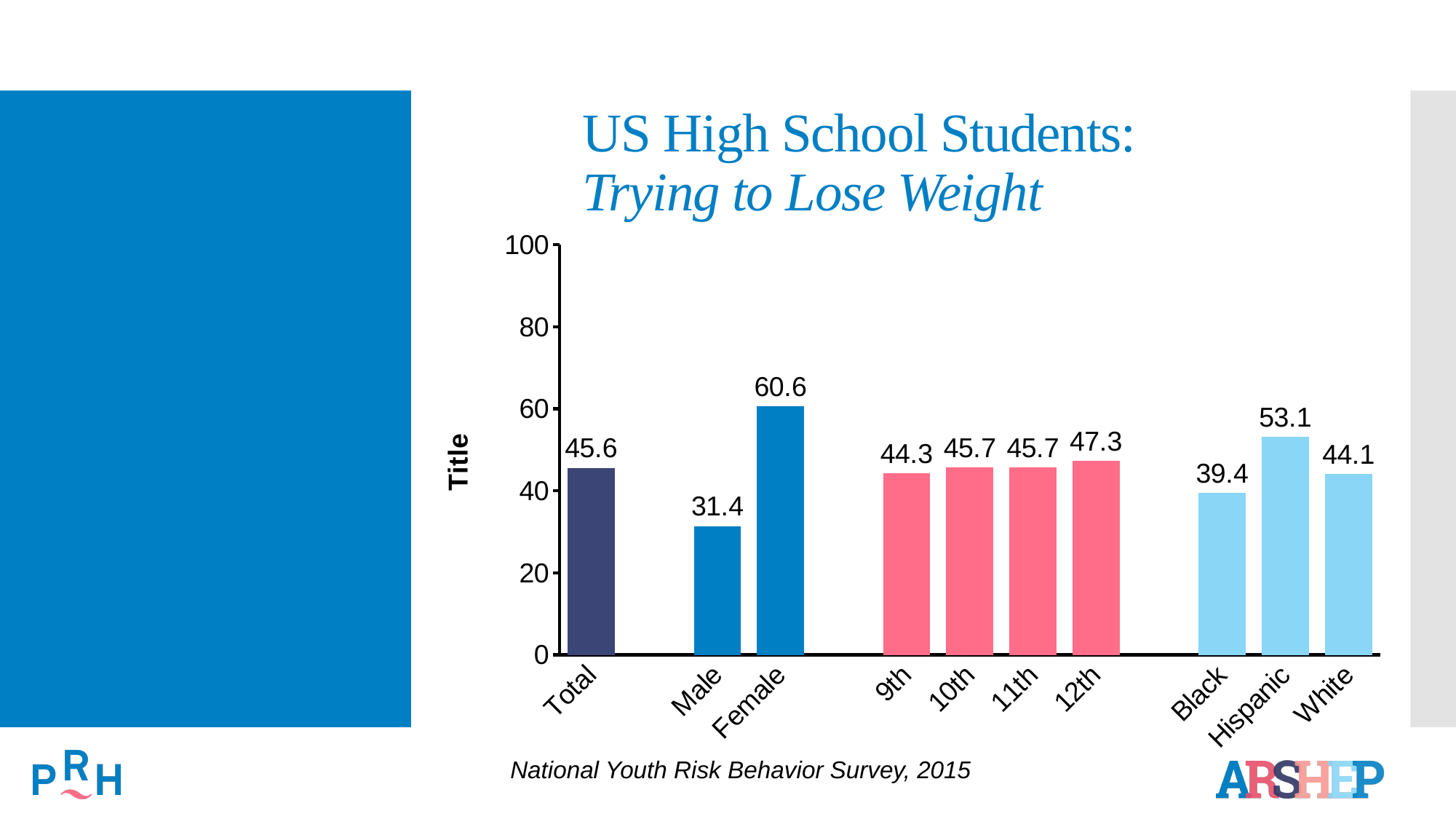
What kind of chart is shown on the slide? bar chart Which category has the lowest value? Male What is the difference between the Hispanic and Black values? 13.7 How many categories are shown on the x axis? 10 What is the value for Hispanic? 53.1 What is the value for Male? 31.4 What is the value for Total? 45.6 Is the value for Female greater or less than 60? greater Which category has the highest value? Female What is the difference between the Female and Male values? 29.2 What is the value for Female? 60.6 Which is larger, the value for 12th or the value for 9th? 12th